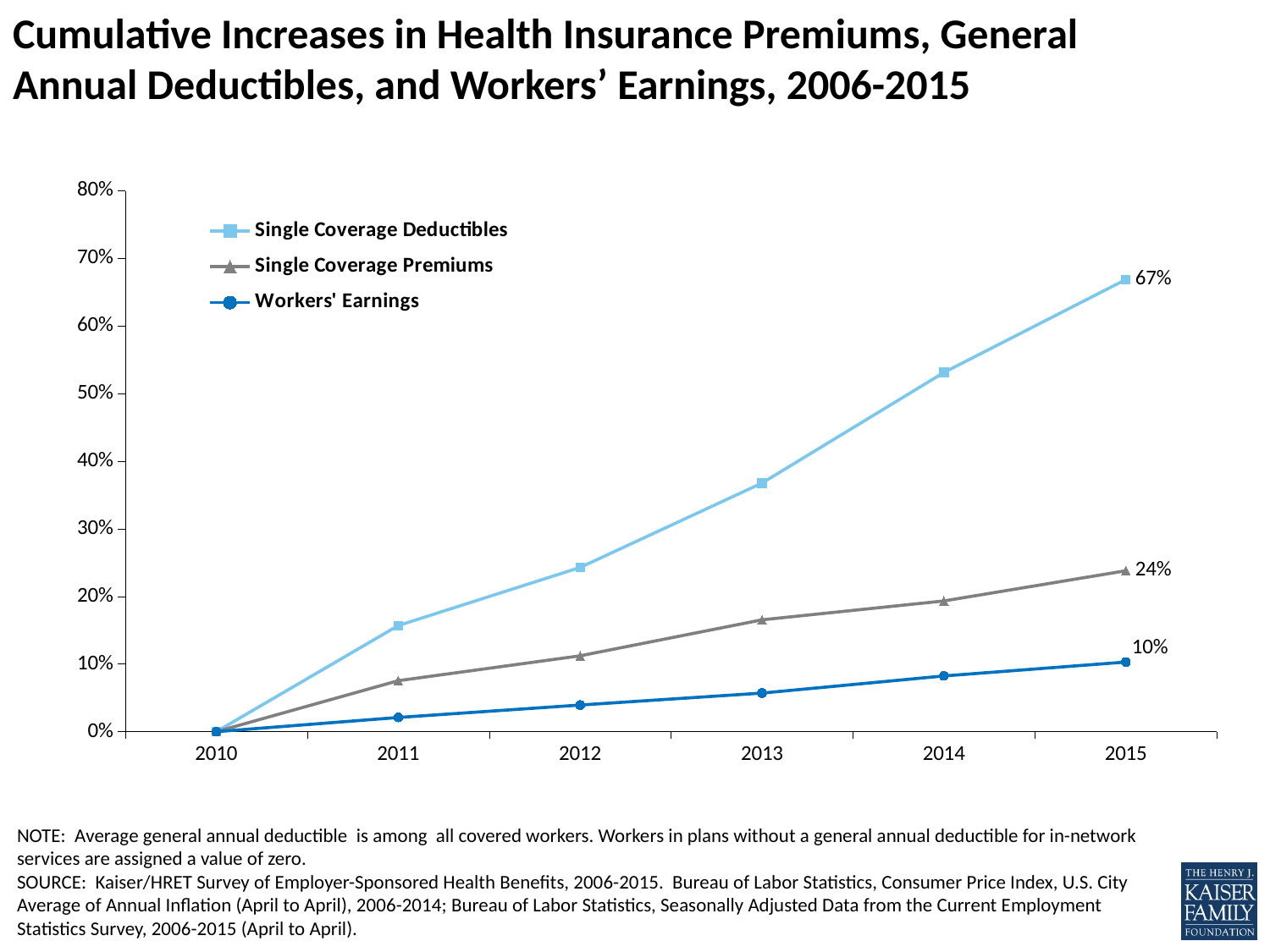
In 2015, which is larger: Single Coverage Premiums or Workers' Earnings? Single Coverage Premiums What is the value for Single Coverage Premiums in 2015? 24% Do the values for Single Coverage Deductibles rise or fall from 2010 to 2015? Rise Which series has the highest value in 2015? Single Coverage Deductibles What is the value for Single Coverage Deductibles in 2015? 67% How many series does the legend list? 3 What is the difference between the 2015 values for Single Coverage Deductibles and Single Coverage Premiums? 43 percentage points Which series has the lowest value in 2015? Workers' Earnings Is the value for Single Coverage Premiums in 2013 greater or less than 20%? less What is the value for Workers' Earnings in 2015? 10% What kind of chart is shown on the slide? Line chart Is the value for Single Coverage Deductibles in 2014 greater or less than 50%? greater